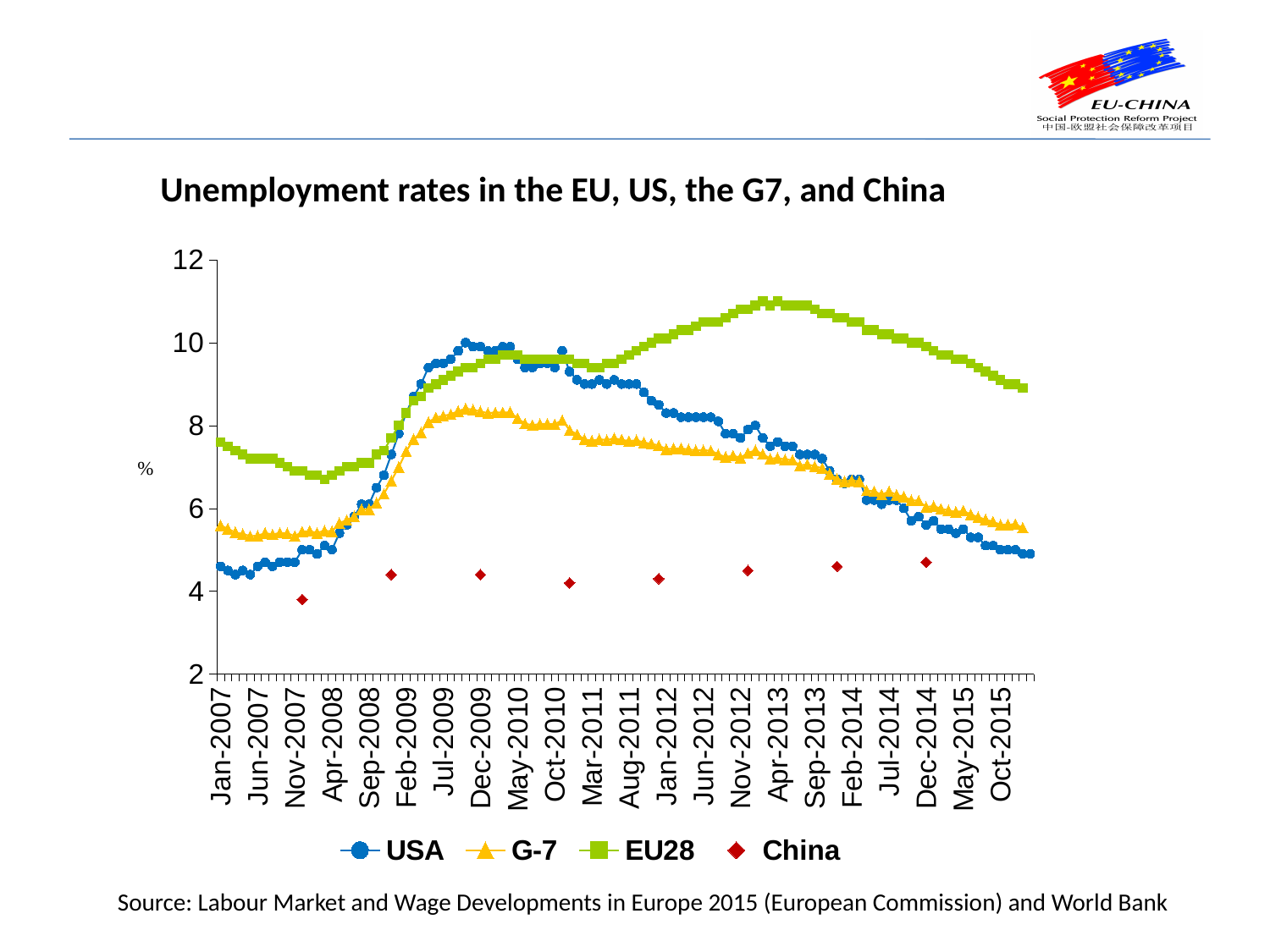
How many series does the legend list? 4 Which series has the higher value at Apr-2013, EU28 or USA? EU28 Which series are listed in the legend? USA, G-7, EU28, China Is the value for USA at Jan-2007 greater or less than 6? less Which series has the higher value at Dec-2009, USA or G-7? USA Is the value for EU28 at Oct-2015 greater or less than 10? less Is the value for EU28 at Apr-2013 greater or less than 10? greater What kind of chart is shown on the slide? line chart Does the EU28 series rise or fall between Apr-2013 and Oct-2015? fall Which series reaches the highest value anywhere on the chart? EU28 What is the title of the chart? Unemployment rates in the EU, US, the G7, and China